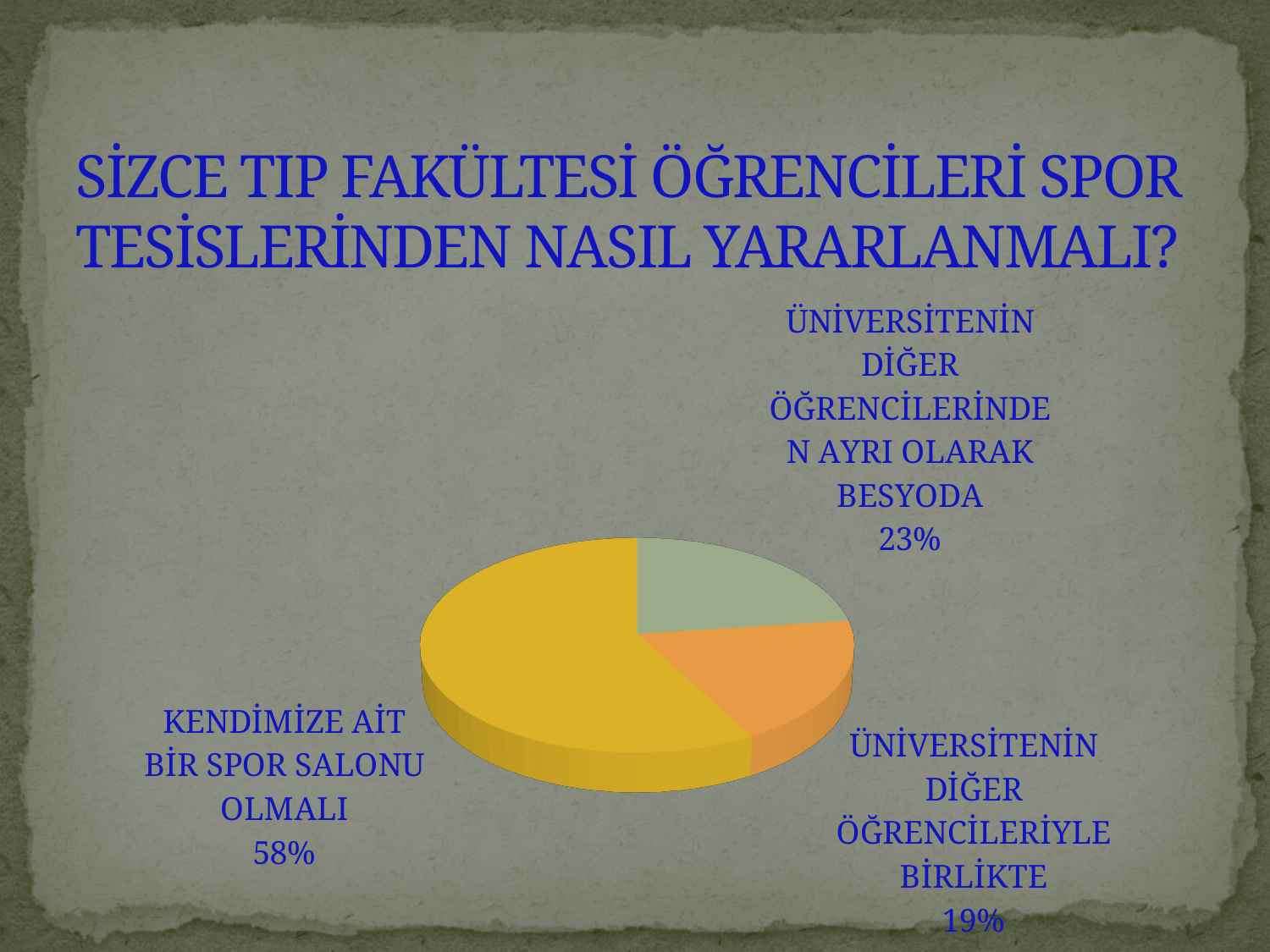
What is the title of the slide containing the pie chart? SİZCE TIP FAKÜLTESİ ÖĞRENCİLERİ SPOR TESİSLERİNDEN NASIL YARARLANMALI? What is the difference in percentage points between "ÜNİVERSİTENİN DİĞER ÖĞRENCİLERİNDEN AYRI OLARAK BESYODA" and "ÜNİVERSİTENİN DİĞER ÖĞRENCİLERİYLE BİRLİKTE"? 4 percentage points What kind of chart is shown on the slide? Pie chart Which category has the largest share of the pie? KENDİMİZE AİT BİR SPOR SALONU OLMALI What percentage is shown for "KENDİMİZE AİT BİR SPOR SALONU OLMALI"? 58% How many slices does the pie chart have? 3 What is the difference in percentage points between "KENDİMİZE AİT BİR SPOR SALONU OLMALI" and "ÜNİVERSİTENİN DİĞER ÖĞRENCİLERİNDEN AYRI OLARAK BESYODA"? 35 percentage points What percentage is shown for "ÜNİVERSİTENİN DİĞER ÖĞRENCİLERİNDEN AYRI OLARAK BESYODA"? 23% What colour is the slice for "KENDİMİZE AİT BİR SPOR SALONU OLMALI"? Yellow What percentage is shown for "ÜNİVERSİTENİN DİĞER ÖĞRENCİLERİYLE BİRLİKTE"? 19% Which category has the smallest share of the pie? ÜNİVERSİTENİN DİĞER ÖĞRENCİLERİYLE BİRLİKTE Which is larger: the share for "ÜNİVERSİTENİN DİĞER ÖĞRENCİLERİNDEN AYRI OLARAK BESYODA" or for "ÜNİVERSİTENİN DİĞER ÖĞRENCİLERİYLE BİRLİKTE"? ÜNİVERSİTENİN DİĞER ÖĞRENCİLERİNDEN AYRI OLARAK BESYODA